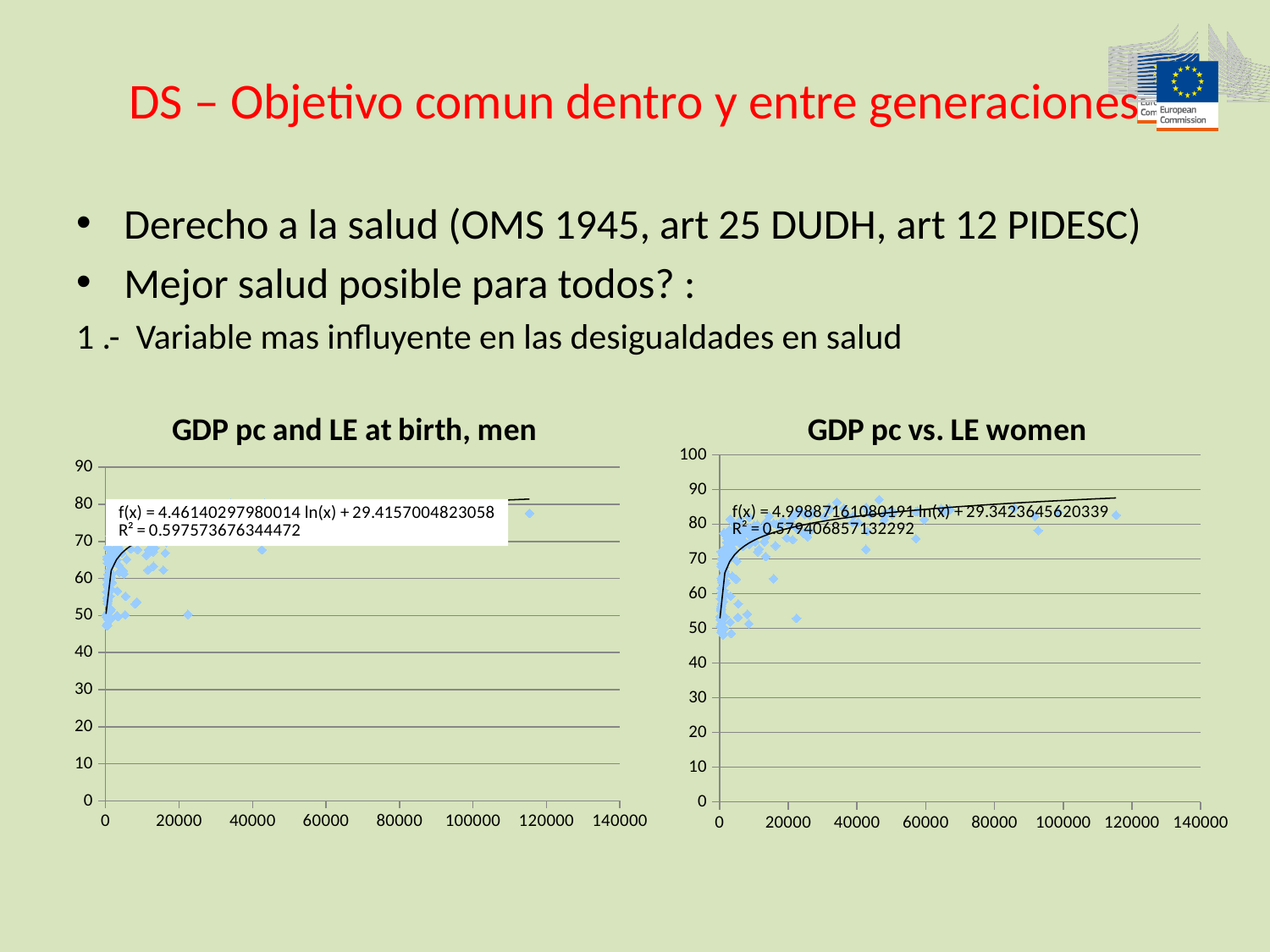
What is the title of the chart on the left of the slide? GDP pc and LE at birth, men In the 'GDP pc and LE at birth, men' chart, do the life expectancy values generally rise or fall as GDP per capita increases along the x axis? rise In the 'GDP pc and LE at birth, men' chart, what is the R² value shown for the trendline? 0.597573676344472 In the 'GDP pc vs. LE women' chart, what is the trendline equation shown? f(x) = 4.99887161080191 ln(x) + 29.3423645620339 In the 'GDP pc and LE at birth, men' chart, what is the trendline equation shown? f(x) = 4.46140297980014 ln(x) + 29.4157004823058 What is the title of the chart on the right of the slide? GDP pc vs. LE women What kind of chart is the 'GDP pc and LE at birth, men' chart? scatter chart What kind of chart is the 'GDP pc vs. LE women' chart? scatter chart In the 'GDP pc vs. LE women' chart, is the value of the point plotted near 115000 on the x axis greater or less than 70? greater Which chart has the higher R² value, 'GDP pc and LE at birth, men' or 'GDP pc vs. LE women'? GDP pc and LE at birth, men In the 'GDP pc vs. LE women' chart, what is the R² value shown for the trendline? 0.579406857132292